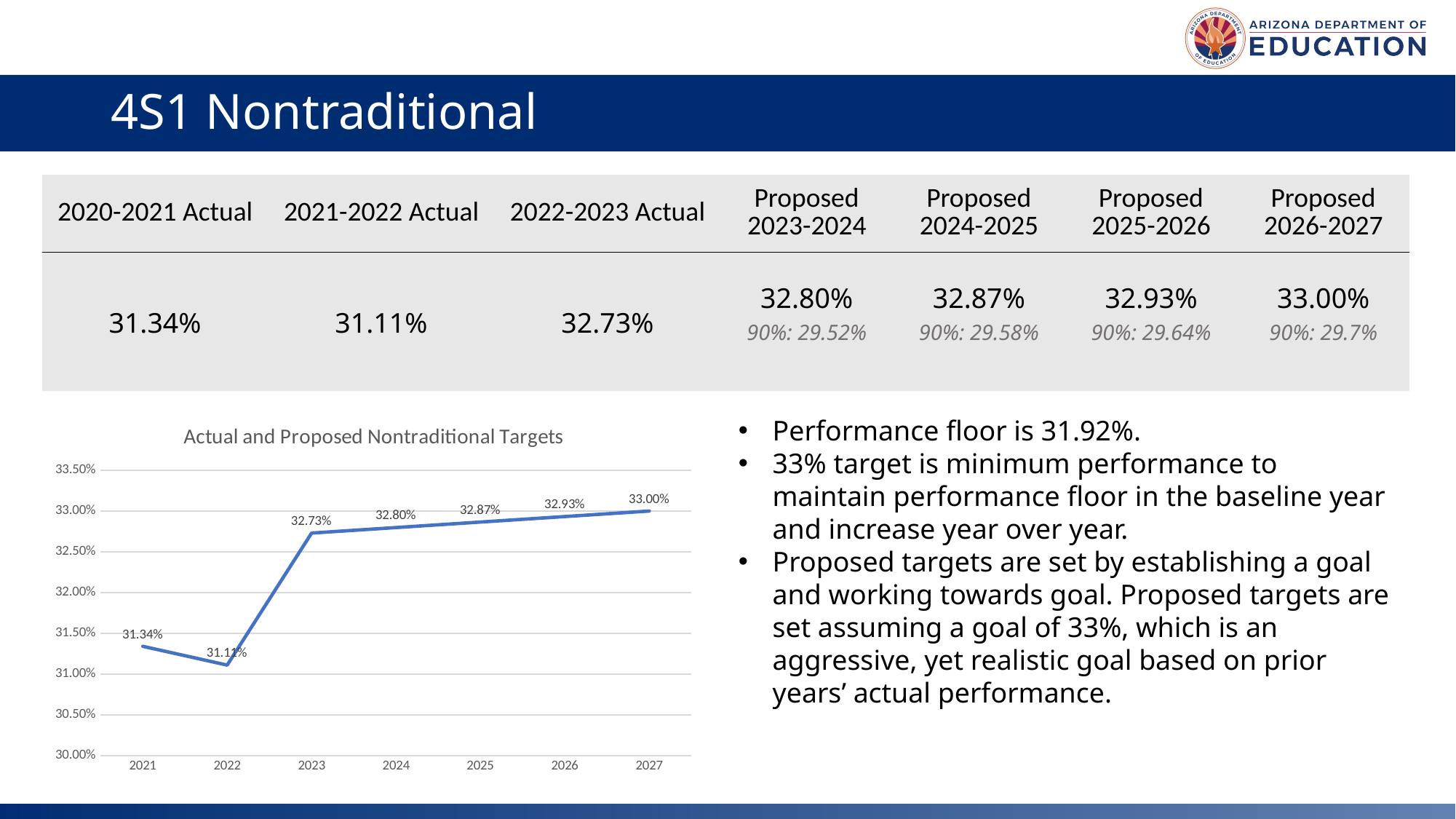
What is the value plotted for 2027 in the chart? 33.00% Which is larger in the chart, the value for 2021 or the value for 2022? 2021 What is the difference between the 2023 value and the 2022 value in the chart? 1.62% What kind of chart is shown on the slide? line chart Do the values in the chart rise or fall from 2023 to 2027? rise Is the value for 2024 in the chart greater or less than 32.50%? greater What is the title of the chart? Actual and Proposed Nontraditional Targets How many years are plotted on the x axis of the chart? 7 Which year has the lowest value in the chart? 2022 What is the value plotted for 2021 in the chart? 31.34% Which year has the highest value in the chart? 2027 What is the value plotted for 2023 in the chart? 32.73%